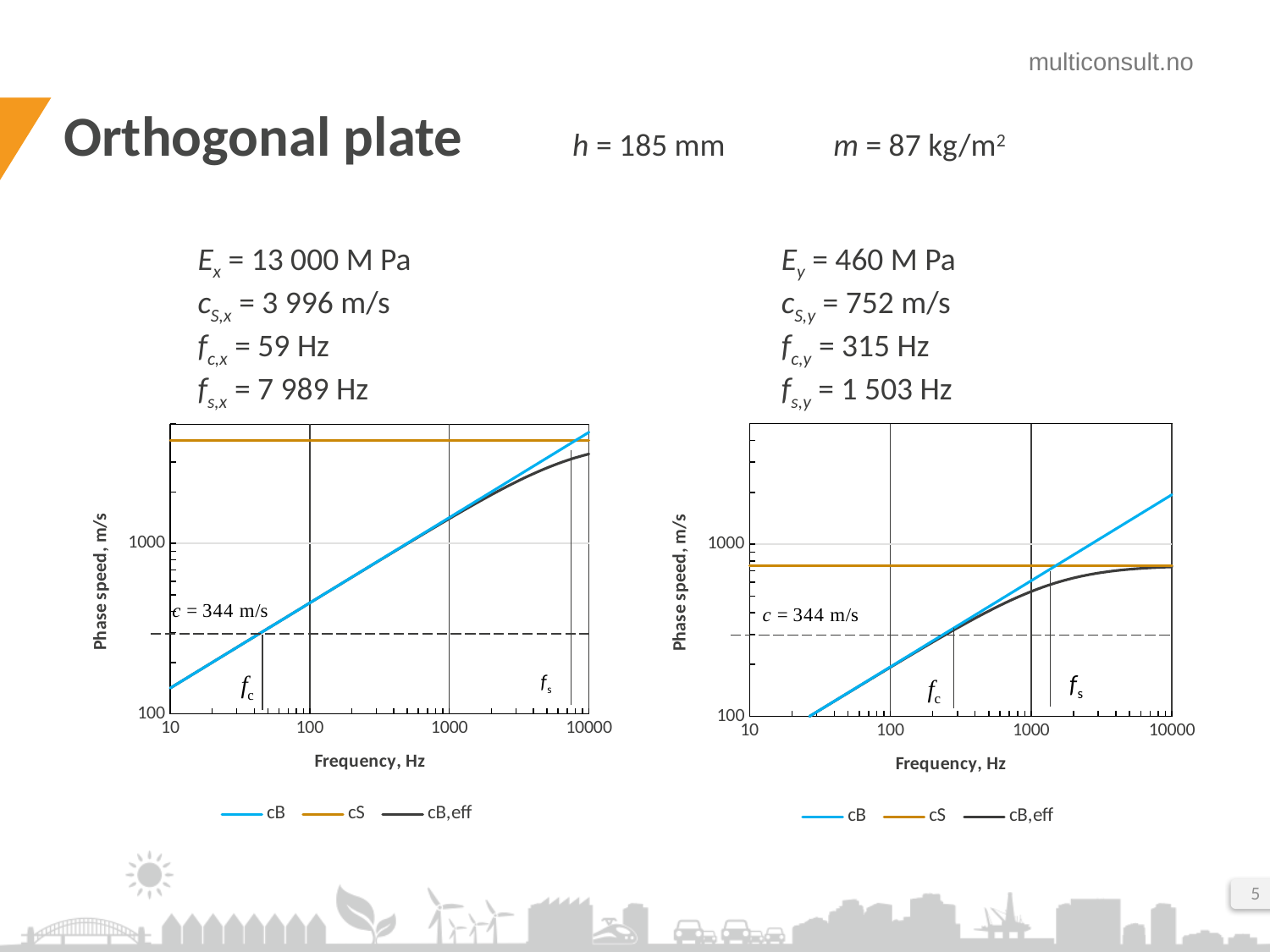
In the left chart, at 10000 Hz, which series has the higher phase speed, cB or cB,eff? cB In the left chart, does the cB,eff series rise or fall as frequency increases? rise In the right chart, is the cB value at 10000 Hz greater or less than 1000 m/s? greater In the left chart, does the cB series rise or fall as frequency increases? rise What speed is marked by the dashed horizontal line in the right chart? c = 344 m/s How many series does the legend of the right chart list? 3 What kind of chart is the left chart on the slide? line chart In the right chart, at 10000 Hz, which series has the higher phase speed, cB or cS? cB In the right chart, is the value of the horizontal cS line greater or less than 1000 m/s? less In the left chart, is the value of the horizontal cS line greater or less than 1000 m/s? greater What is the label of the x axis of the left chart? Frequency, Hz